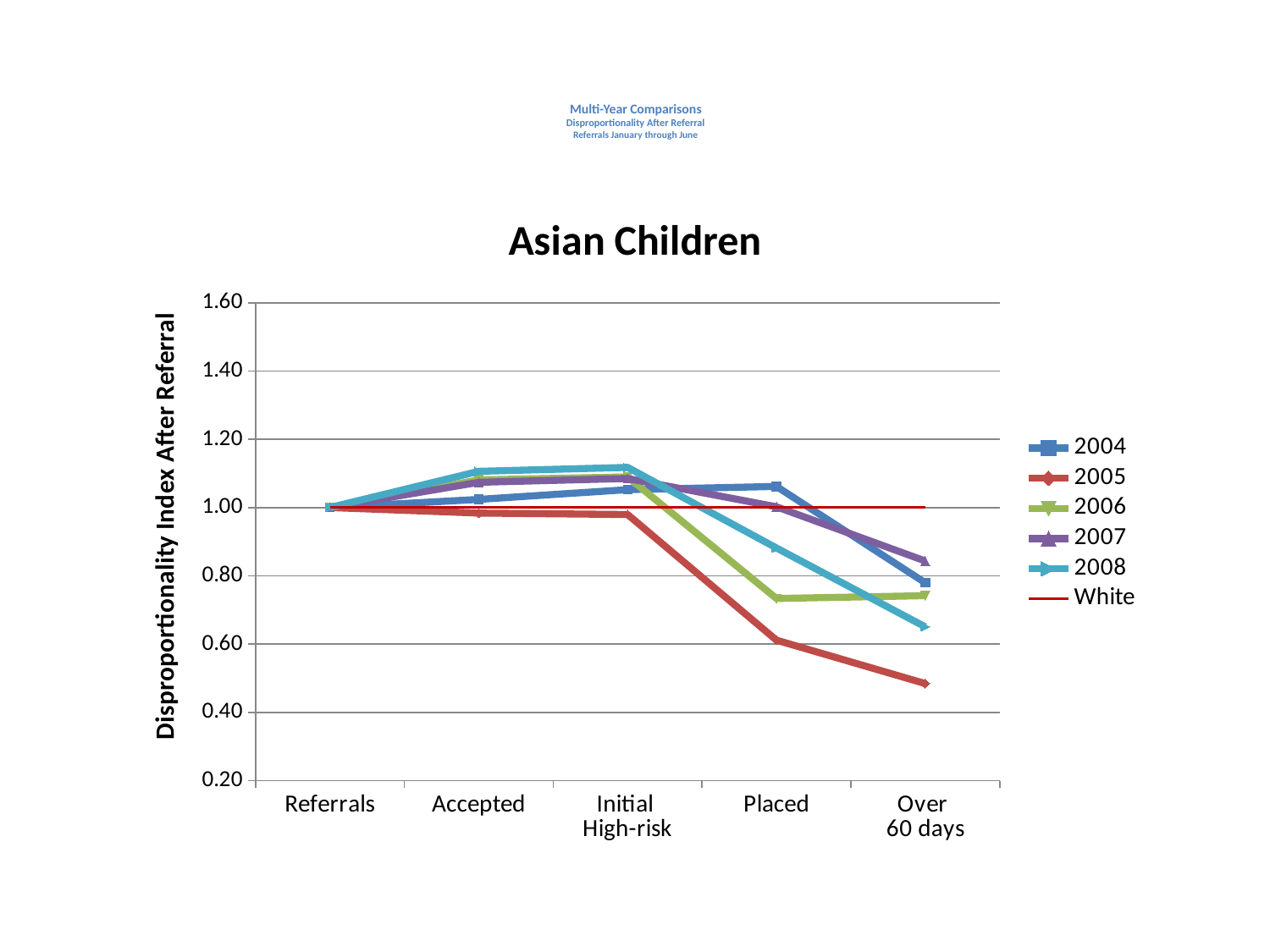
How many categories are shown on the x axis? 5 What is the value for 2005 at Referrals? 1.00 Is the value for 2005 at Over 60 days greater or less than 0.60? less How many series does the legend list? 6 Which year series has the highest value at Over 60 days? 2007 Is the value for 2006 at Placed greater or less than 0.80? less Does the 2005 series rise or fall from Referrals to Over 60 days? fall What is the value of the White series at Placed? 1.00 Is the value for 2004 at Placed greater or less than 1.00? greater Which year series has the lowest value at Over 60 days? 2005 What is the title of the chart? Asian Children What type of chart is shown on the slide? line chart